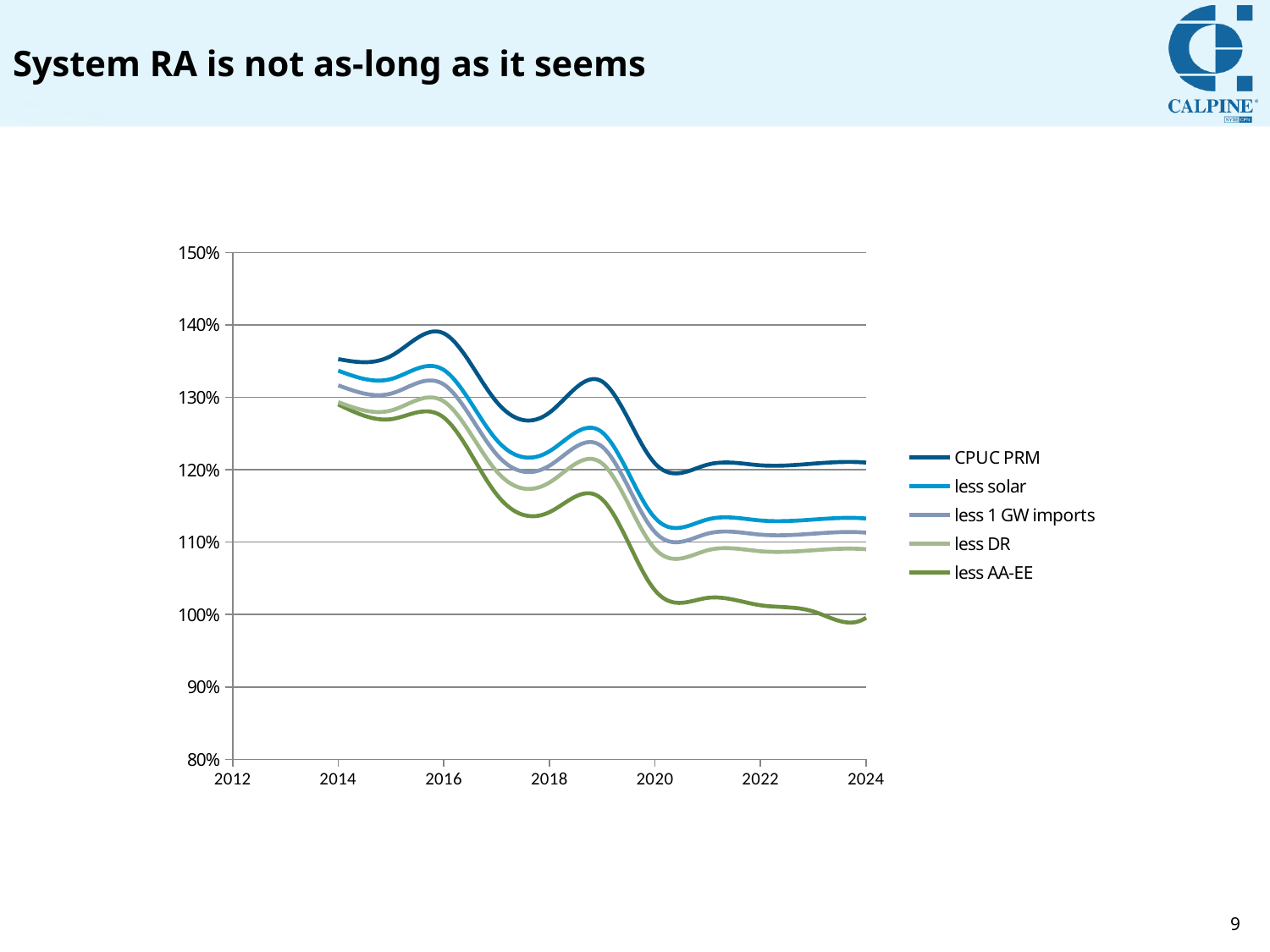
In 2020, which is larger: the value for CPUC PRM or the value for less AA-EE? CPUC PRM Is the value for CPUC PRM in 2014 greater or less than 130%? greater Which series has the highest values across the whole chart? CPUC PRM What is the first series listed in the legend? CPUC PRM Is the value for less AA-EE in 2018 greater or less than 120%? less Which series has the lowest values across the whole chart? less AA-EE Is the value for less AA-EE in 2020 greater or less than 100%? greater How many series does the legend list? 5 Do the values of the CPUC PRM series rise or fall overall from 2014 to 2024? fall What is the highest value shown on the vertical axis? 150% What kind of chart is shown on the slide? line chart